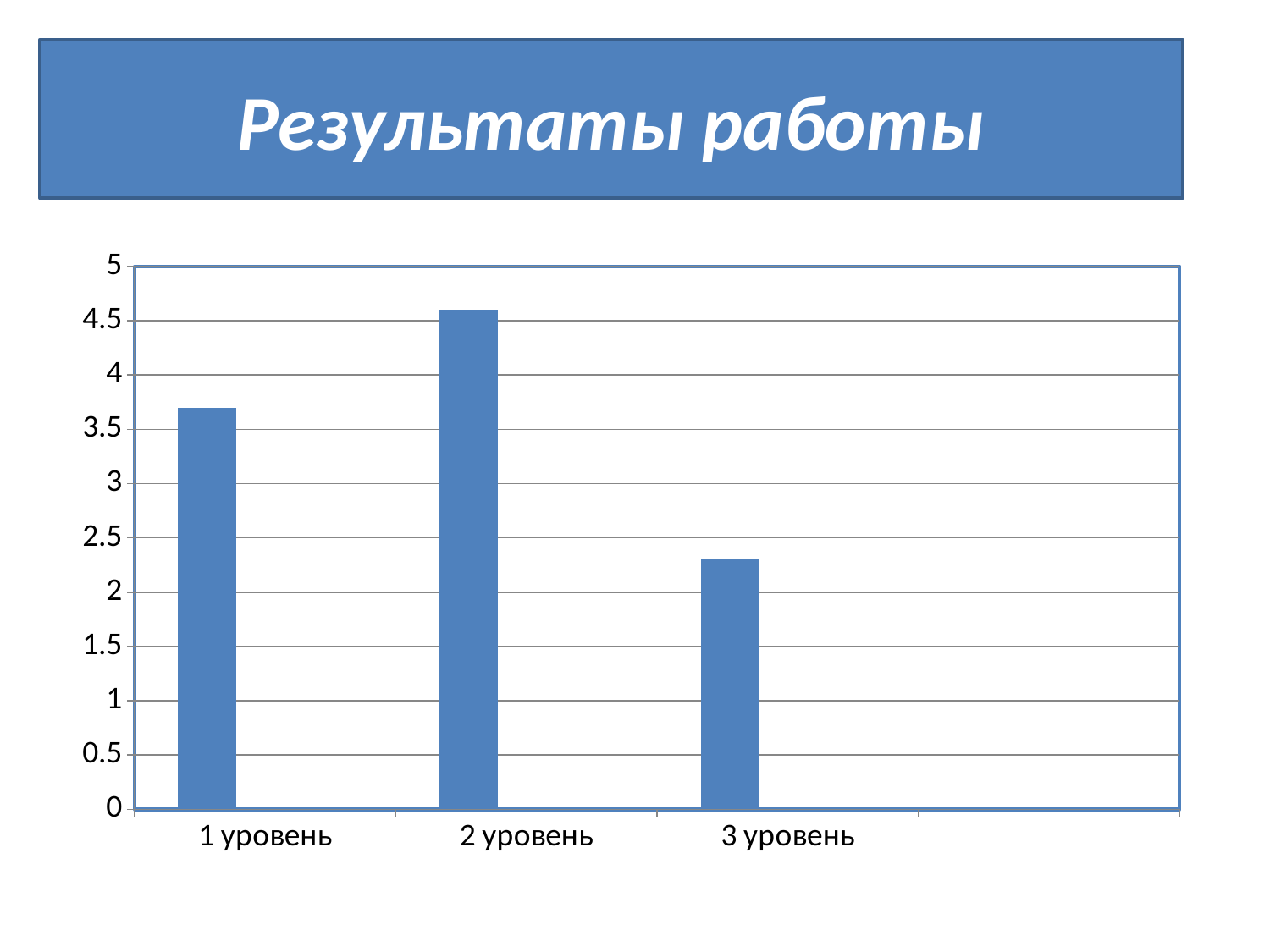
Which category has the highest bar in the chart? 2 уровень What kind of chart is shown on the slide? bar chart How many labelled categories are shown on the x axis of the chart? 3 What is the title shown above the chart on the slide? Результаты работы Which is larger, the value for 1 уровень or the value for 3 уровень? 1 уровень Is the value for 2 уровень greater or less than 4.5? greater Which category has the lowest bar in the chart? 3 уровень Is the value for 1 уровень greater or less than 4? less Is the value for 3 уровень greater or less than 2? greater Which is larger, the value for 2 уровень or the value for 1 уровень? 2 уровень